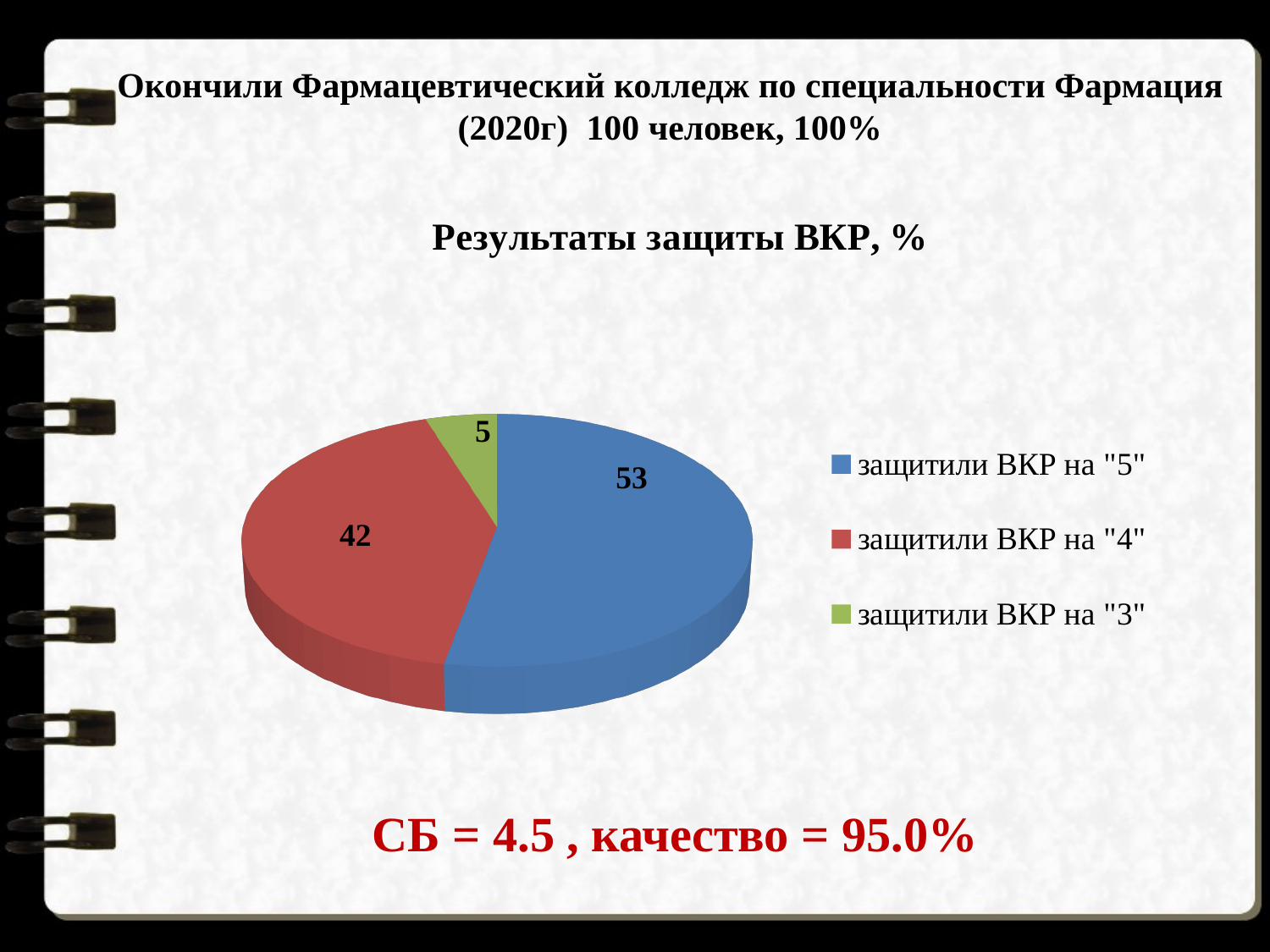
What is the difference between the values for защитили ВКР на "4" and защитили ВКР на "3"? 37 Which category has the smallest slice of the pie? защитили ВКР на "3" Which category has the largest slice of the pie? защитили ВКР на "5" Which is larger: the value for защитили ВКР на "4" or the value for защитили ВКР на "3"? защитили ВКР на "4" What kind of chart is shown on the slide? pie chart What is the value for защитили ВКР на "5"? 53 What is the value for защитили ВКР на "4"? 42 What colour is the slice for защитили ВКР на "3"? green What is the value for защитили ВКР на "3"? 5 What is the difference between the values for защитили ВКР на "5" and защитили ВКР на "4"? 11 How many slices does the pie chart have? 3 What is the title of the chart? Результаты защиты ВКР, %